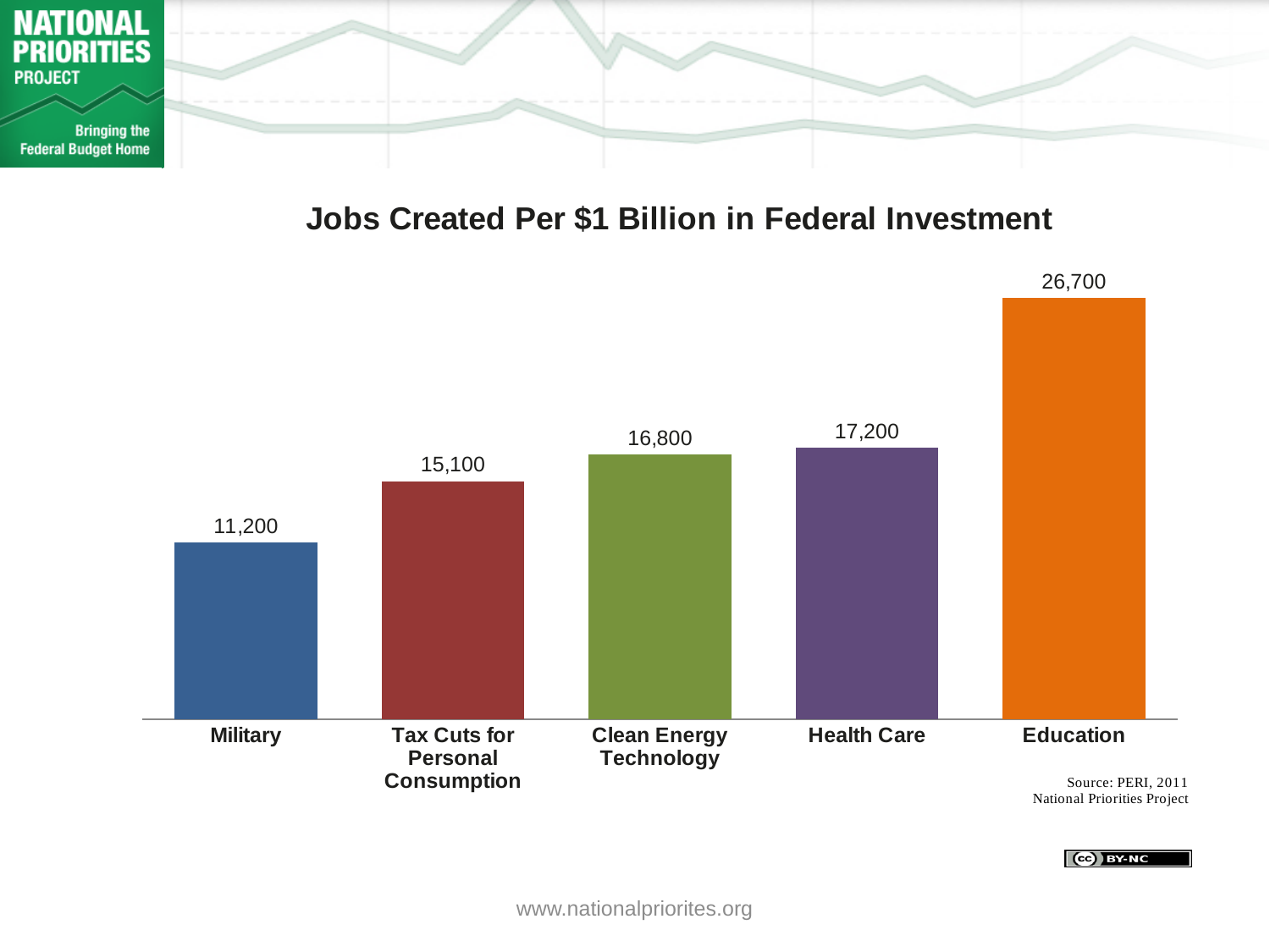
What is the value for Tax Cuts for Personal Consumption? 15,100 How many jobs are created per $1 billion in federal investment in Military? 11,200 What is the value for Clean Energy Technology? 16,800 Which category creates the most jobs per $1 billion? Education How many categories are shown in the chart? 5 Which is larger, the value for Health Care or the value for Tax Cuts for Personal Consumption? Health Care What is the difference between the values for Health Care and Clean Energy Technology? 400 What is the title of the chart? Jobs Created Per $1 Billion in Federal Investment Which category creates the fewest jobs per $1 billion? Military What kind of chart is shown on the slide? Bar chart What is the value for Education? 26,700 What is the difference between the values for Education and Military? 15,500